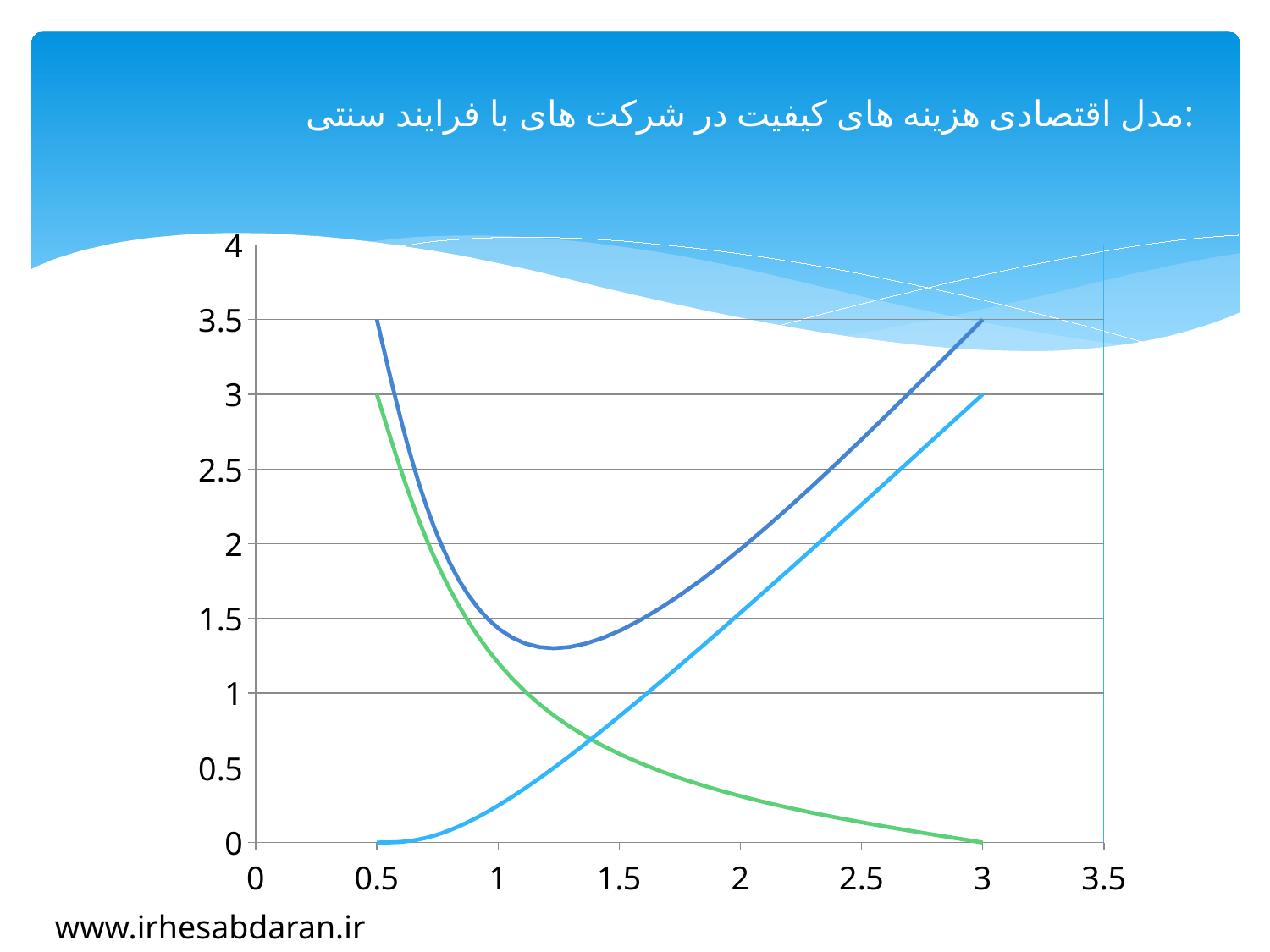
At x = 2.5, which line has the larger value, the dark blue line or the green line? dark blue line What is the value of the green line at x = 0.5? 3 What is the highest value shown on the vertical axis? 4 Is the value of the green line at x = 2 greater or less than 1? less How many lines are plotted on the chart? 3 Does the light blue line rise or fall as x increases? rises Is the value of the dark blue line at x = 1.5 greater or less than 2? less What is the value of the light blue line at x = 3? 3 What kind of chart is shown on the slide? line chart What is the value of the dark blue line at x = 3? 3.5 What is the value of the green line at x = 3? 0 Does the green line rise or fall as x increases? falls